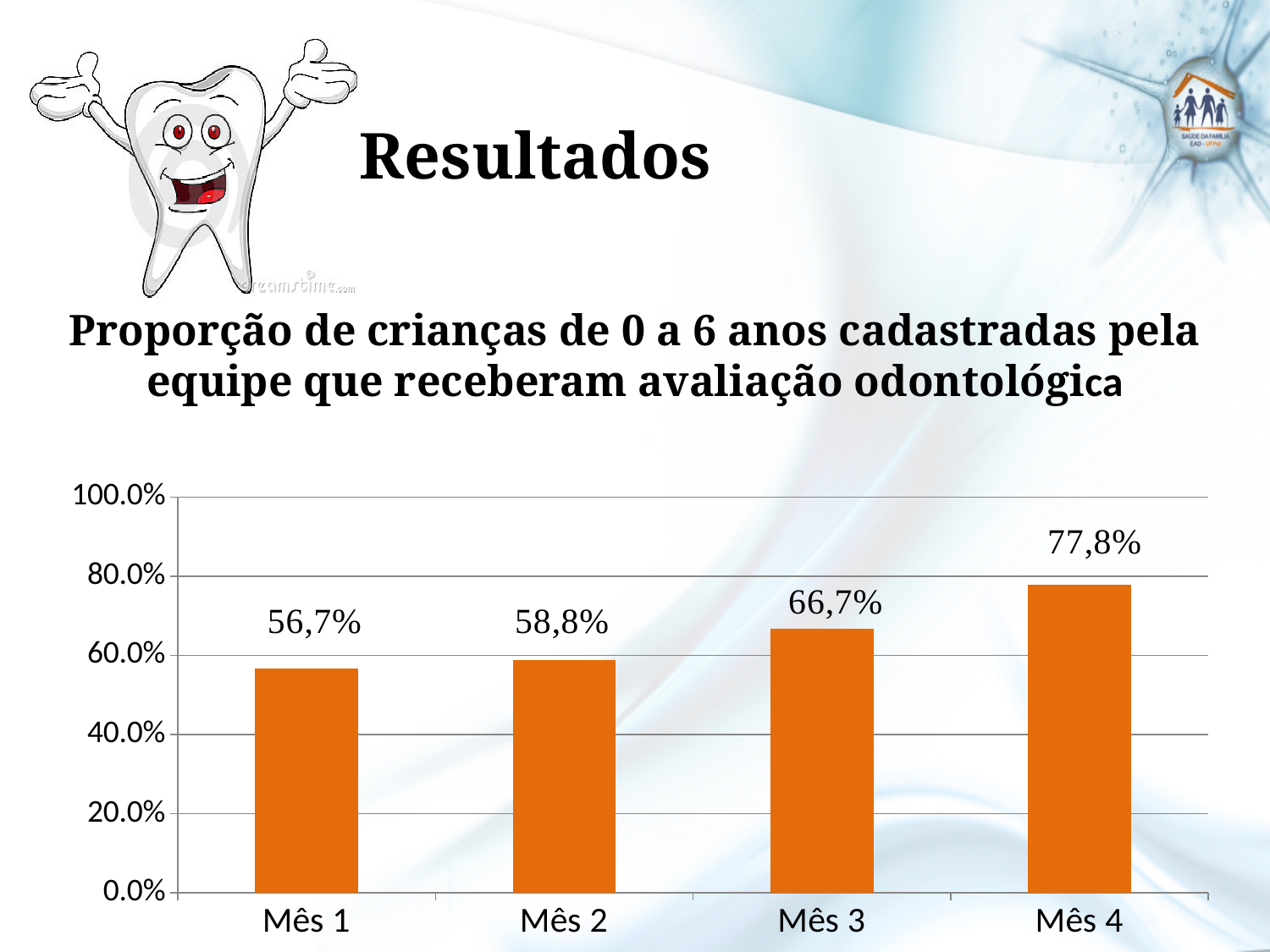
Do the values rise or fall from Mês 1 to Mês 4? rise What is the difference between the values for Mês 4 and Mês 1? 21,1% What is the value for Mês 4? 77,8% What is the difference between the values for Mês 3 and Mês 2? 7,9% Which month has the lowest value? Mês 1 Which month has the highest value? Mês 4 Is the value for Mês 4 greater or less than 80.0%? less What kind of chart is shown on the slide? bar chart Which is larger, the value for Mês 2 or the value for Mês 3? Mês 3 How many months are shown on the x axis? 4 What is the value for Mês 3? 66,7% What is the value for Mês 1? 56,7%